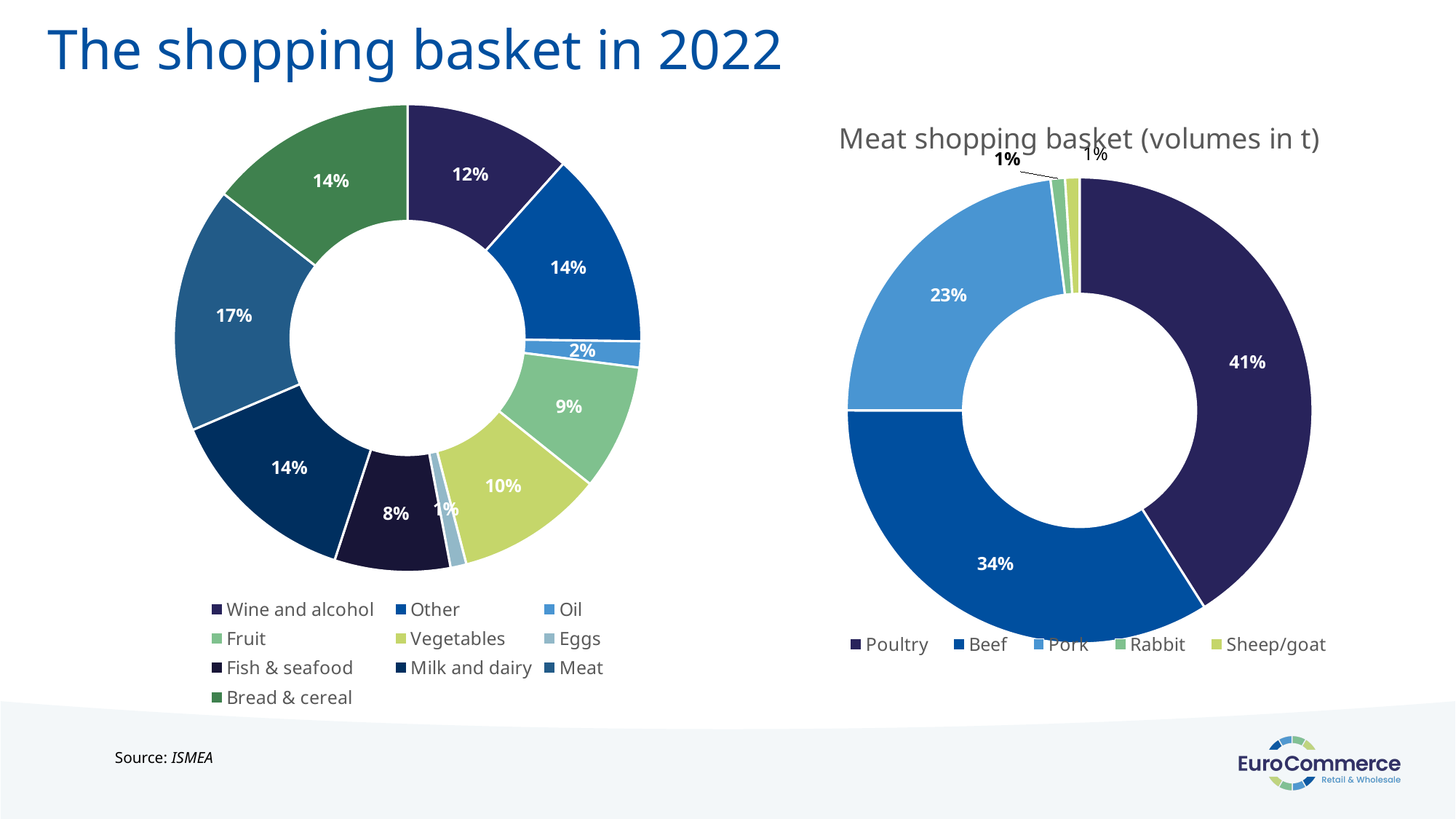
On the Meat shopping basket chart, which is larger, Beef or Pork? Beef On the Meat shopping basket chart, which category has the largest share? Poultry On the Meat shopping basket chart, how many categories does the legend list? 5 What type of chart is the Meat shopping basket chart? Doughnut chart On the left chart, how many categories are shown? 10 On the left chart, which category has the smallest share? Eggs On the Meat shopping basket chart, what share does Beef have? 34% On the left chart, what share does Fish & seafood have? 8% On the left chart, what is the difference between the shares of Meat and Fruit? 8% On the left chart, what share does Meat have? 17% On the left chart, which category has the largest share? Meat On the Meat shopping basket chart, what is the difference between the shares of Poultry and Pork? 18%